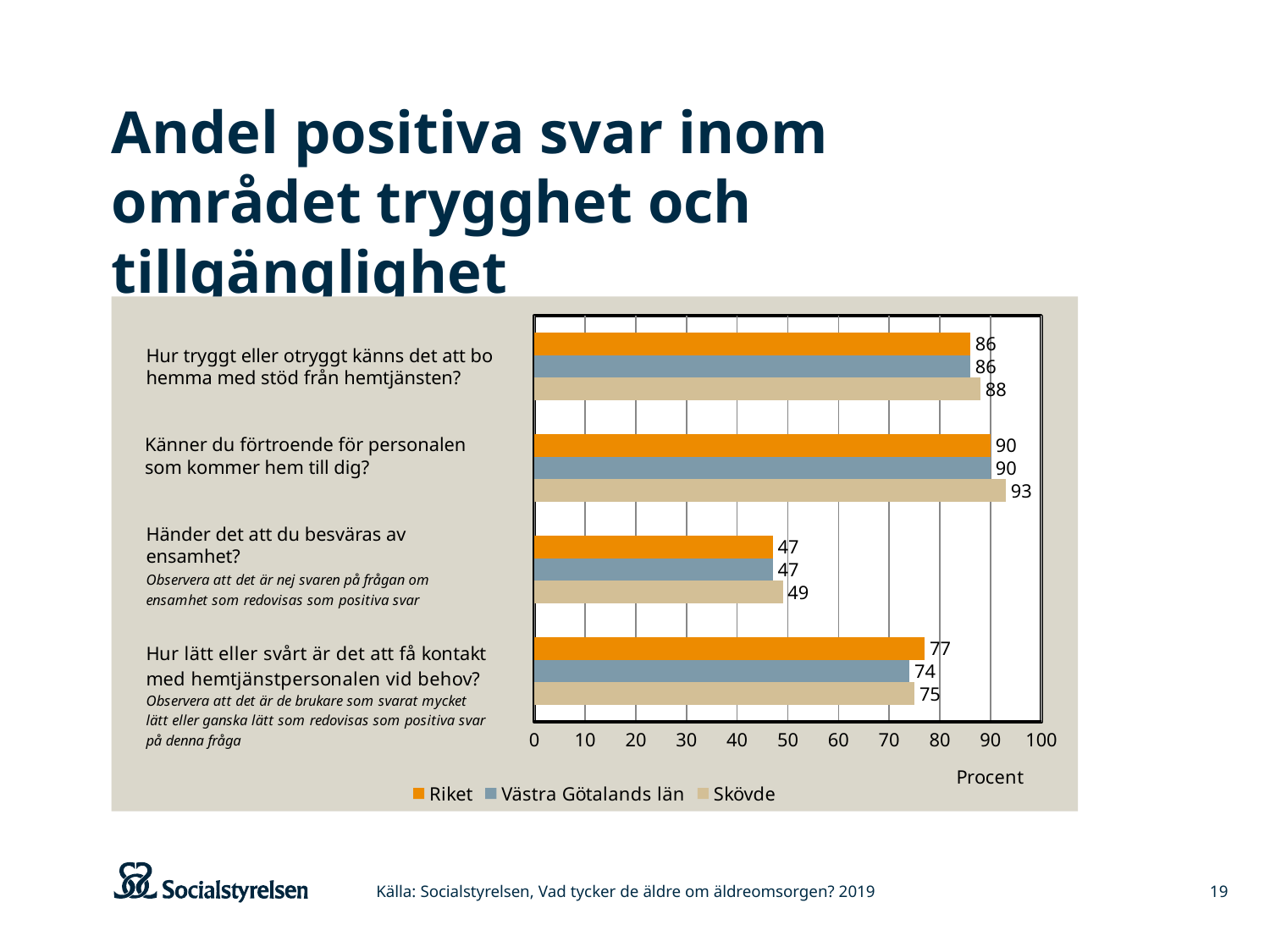
What is the label of the x axis? Procent What is the value for Skövde on the question "Känner du förtroende för personalen som kommer hem till dig?"? 93 Which question has the lowest value for Riket? Händer det att du besväras av ensamhet? How many questions (categories) are shown in the chart? 4 Which question has the highest value for Skövde? Känner du förtroende för personalen som kommer hem till dig? How many series does the legend list? 3 What is the value for Skövde on the question "Hur tryggt eller otryggt känns det att bo hemma med stöd från hemtjänsten?"? 88 What is the value for Riket on the question "Hur lätt eller svårt är det att få kontakt med hemtjänstpersonalen vid behov?"? 77 What kind of chart is shown on the slide? Bar chart On the question "Hur lätt eller svårt är det att få kontakt med hemtjänstpersonalen vid behov?", which is larger: the value for Riket or the value for Västra Götalands län? Riket What is the value for Västra Götalands län on the question "Händer det att du besväras av ensamhet?"? 47 What is the difference between the Skövde value and the Riket value on the question "Känner du förtroende för personalen som kommer hem till dig?"? 3